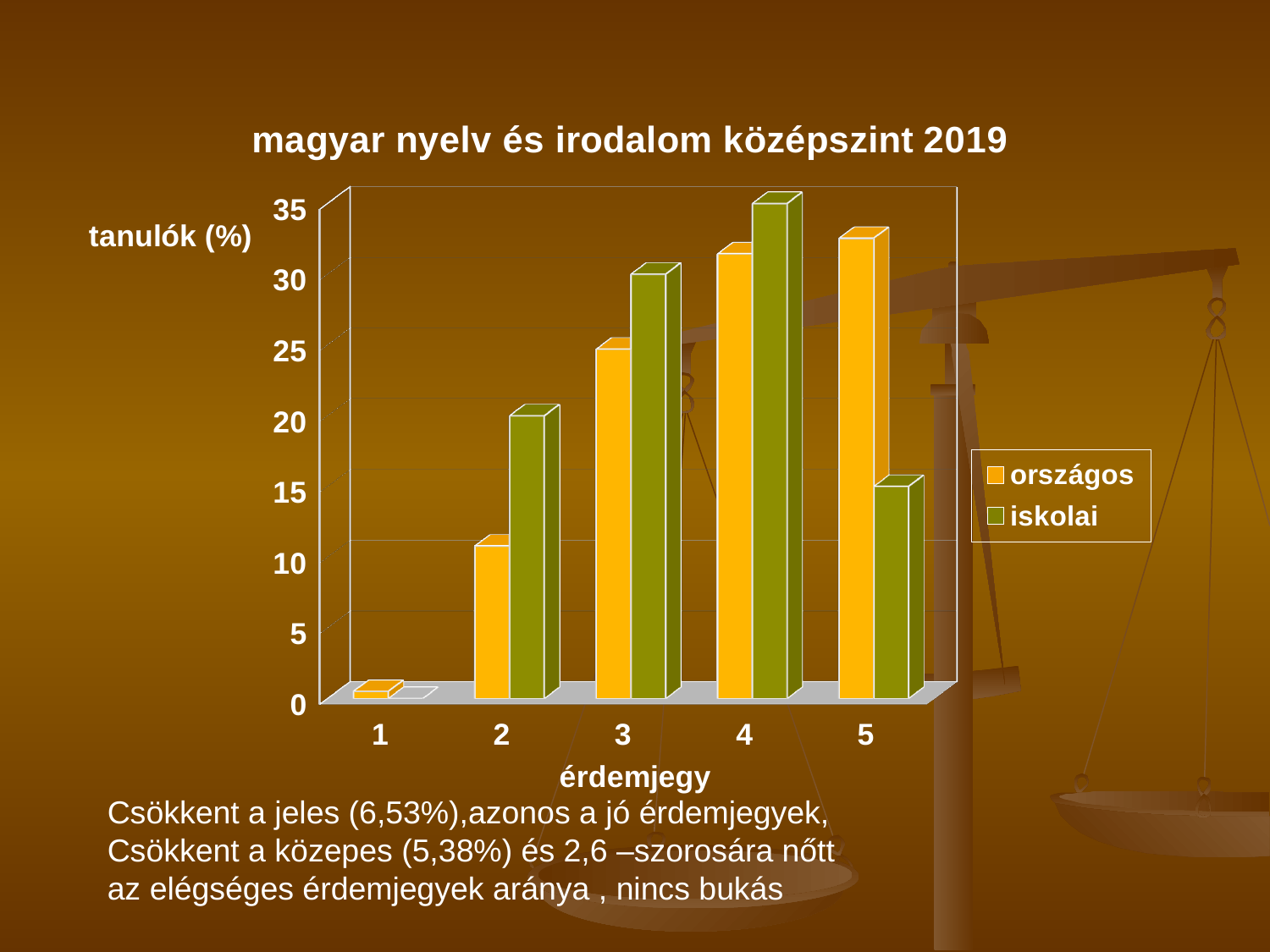
For érdemjegy 5, which series has the larger value, országos or iskolai? országos Is the iskolai value for érdemjegy 5 greater or less than 20? less For érdemjegy 2, which series has the larger value, országos or iskolai? iskolai What is the title of the chart? magyar nyelv és irodalom középszint 2019 How many series does the legend list? 2 Is the iskolai value for érdemjegy 3 greater or less than 25? greater For which érdemjegy is the iskolai value highest? 4 Do the országos values rise or fall as érdemjegy goes from 1 to 5? rise For which érdemjegy is the országos value highest? 5 What type of chart is shown on the slide? bar chart For which érdemjegy is the iskolai value lowest? 1 How many érdemjegy categories are shown on the x axis? 5